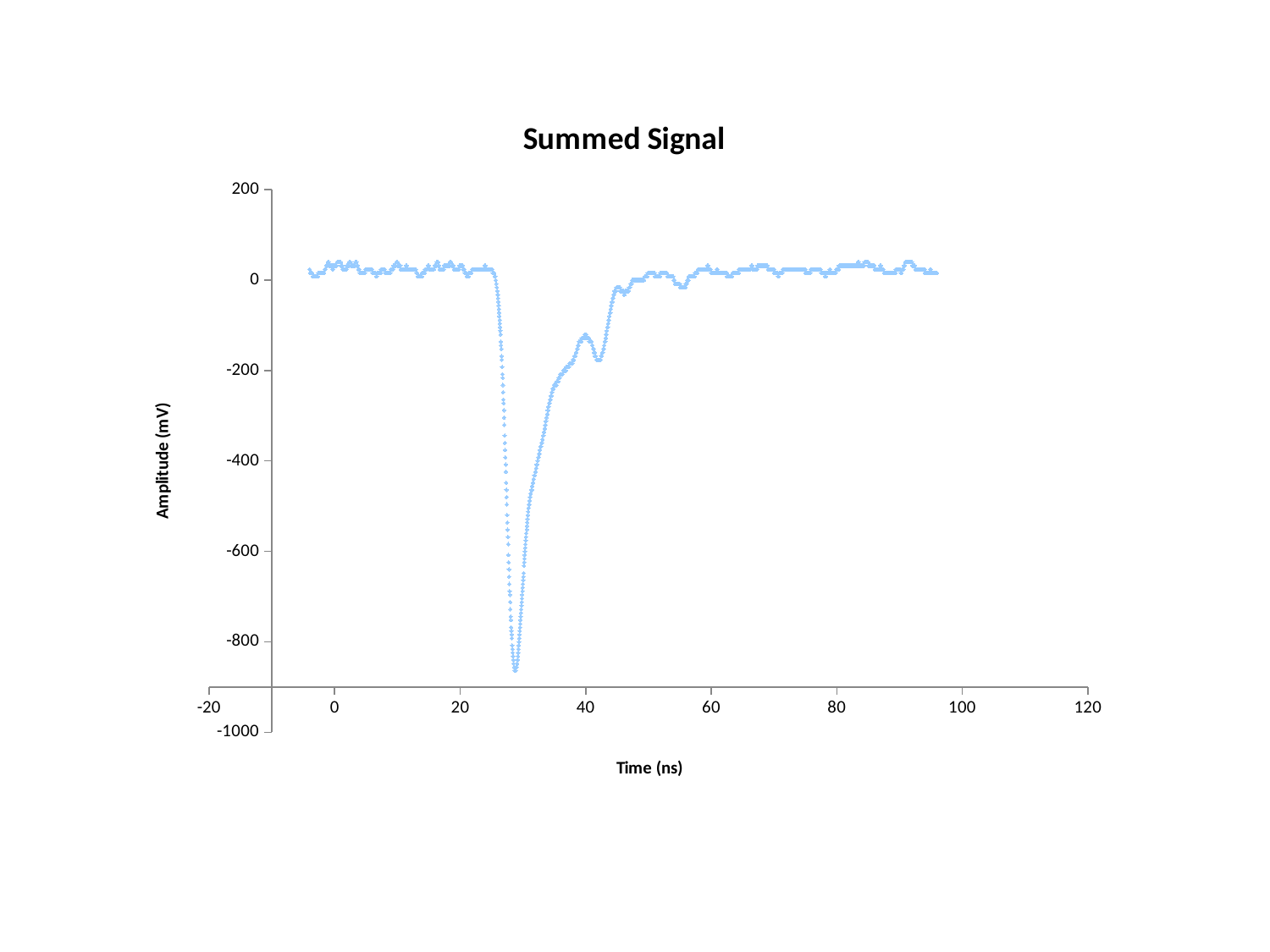
Between 25 ns and 29 ns, does the amplitude rise or fall as time increases? fall Between 30 ns and 40 ns, does the amplitude rise or fall as time increases? rise Is the amplitude at time 80 ns greater or less than -200? greater What is the title of the chart? Summed Signal Is the amplitude at time 60 ns greater or less than -200? greater Is the amplitude at 30 ns larger or smaller than the amplitude at 50 ns? smaller Is the amplitude at time 0 ns greater or less than 100? less What is the label of the vertical axis? Amplitude (mV) What kind of chart is shown on the slide? Scatter chart